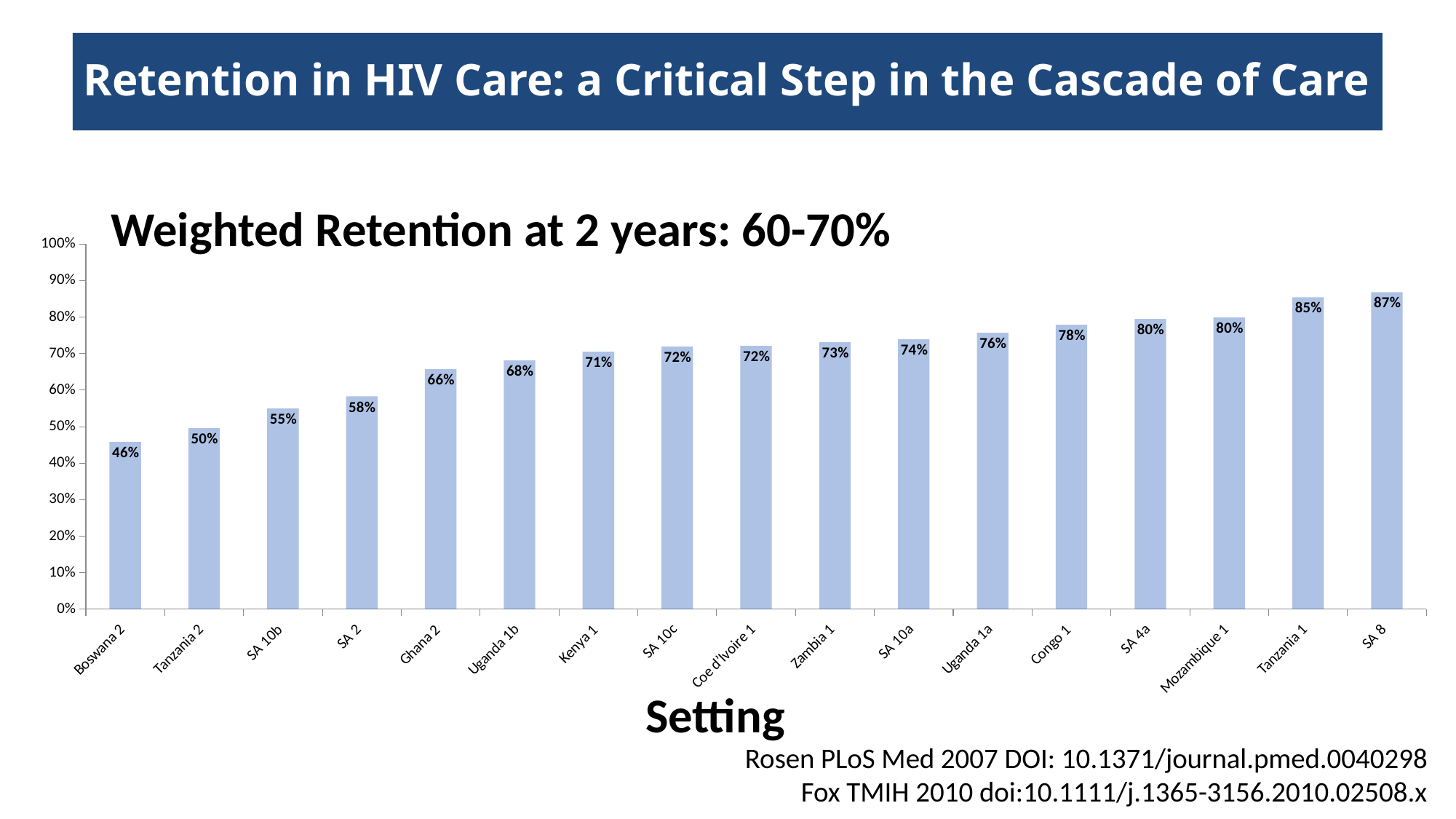
How many settings are shown on the x axis? 17 What is the retention value shown for Ghana 2? 66% Do the retention values rise or fall from left to right along the x axis? rise What kind of chart is shown on the slide? bar chart What is the retention value shown for Tanzania 1? 85% What is the difference between the retention values for SA 8 and Boswana 2? 41% Which setting has the lowest retention value? Boswana 2 Is the value for SA 10b greater or less than 60%? less What is the difference between the retention values for Congo 1 and SA 2? 20% What is the retention value shown for Kenya 1? 71% Which setting has the highest retention value? SA 8 Which has a higher retention value, Uganda 1a or Zambia 1? Uganda 1a